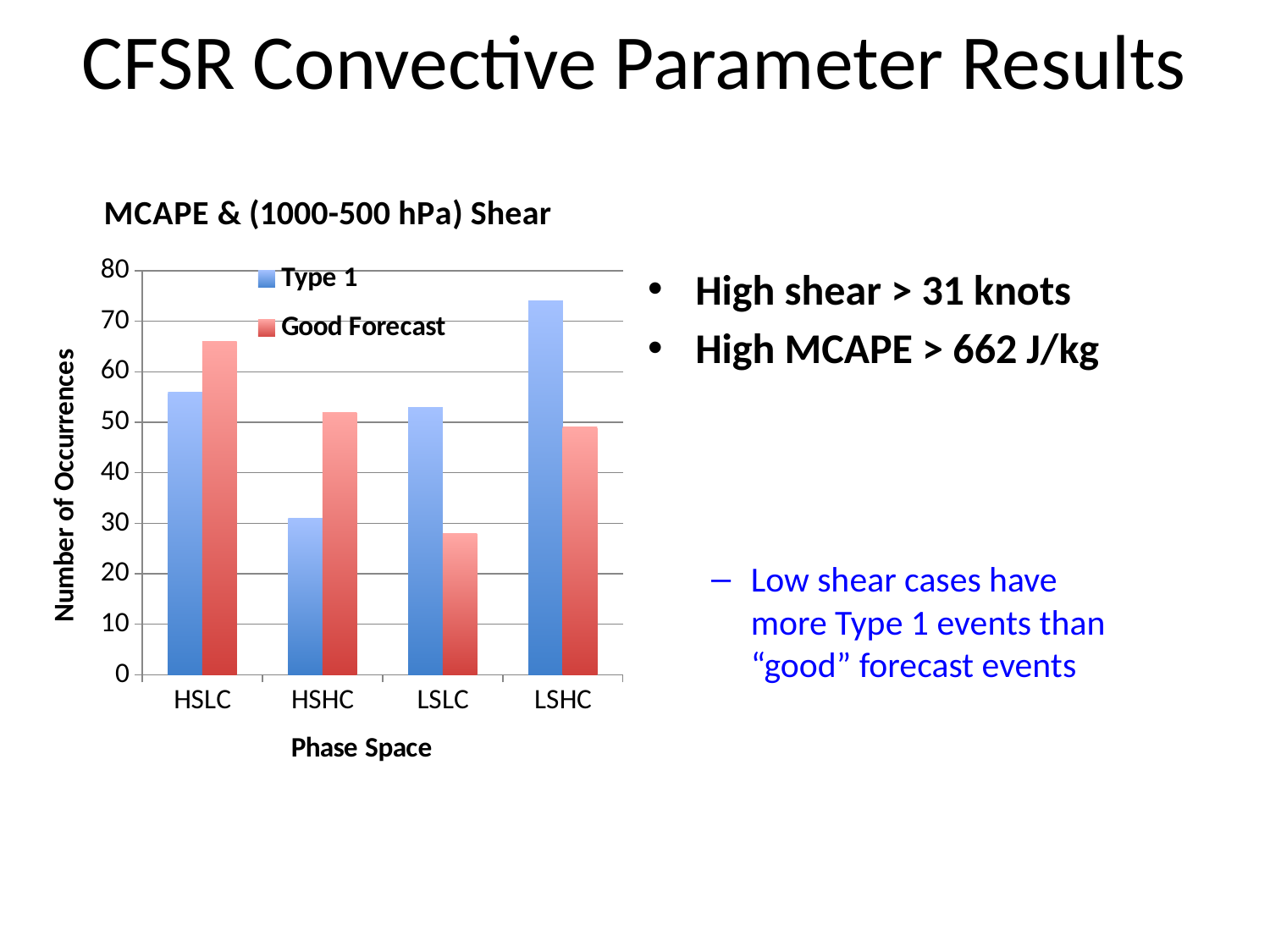
For LSLC, which series has the larger value, Type 1 or Good Forecast? Type 1 Which phase space category has the highest Good Forecast value? HSLC For HSLC, which series has the larger value, Type 1 or Good Forecast? Good Forecast Which phase space category has the lowest Good Forecast value? LSLC Is the Type 1 value for LSHC greater or less than 70? greater What is the title of the chart? MCAPE & (1000-500 hPa) Shear Which phase space category has the lowest Type 1 value? HSHC How many phase space categories are shown on the x axis? 4 Which phase space category has the highest Type 1 value? LSHC Is the Type 1 value for HSHC greater or less than 40? less What type of chart is shown on the slide? bar chart How many series does the chart legend list? 2